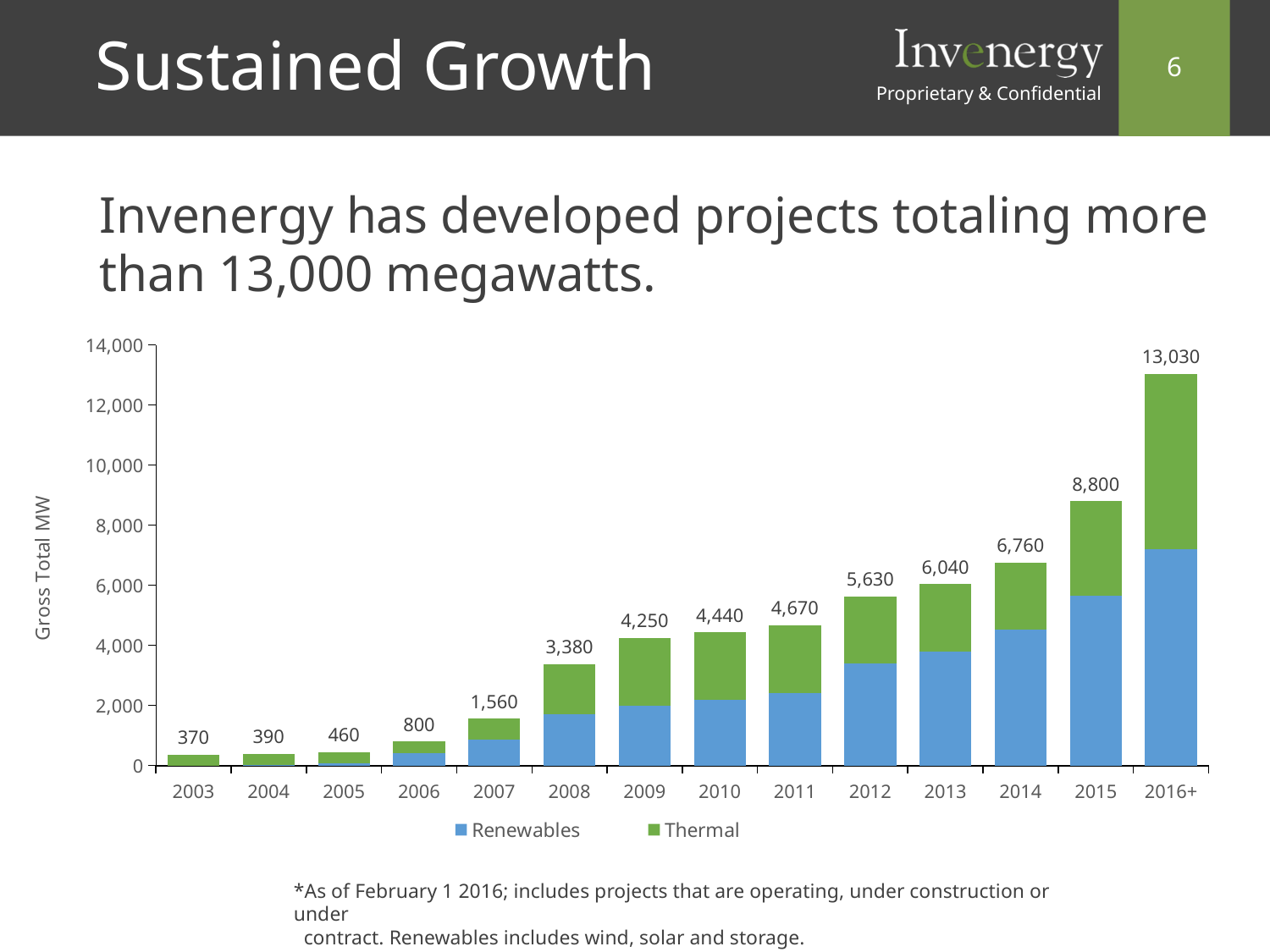
What is the total value labeled on the bar for 2008? 3,380 Is the Renewables value for 2012 greater or less than 2,000? greater Which is larger, the total for 2010 or the total for 2011? 2011 How many years (categories) are shown on the x axis? 14 Do the total values rise or fall from 2003 to 2016+? Rise How many series does the legend list? 2 What kind of chart is shown on the slide? Stacked bar chart What is the total gross MW shown for 2016+? 13,030 Is the Renewables value for 2016+ greater or less than 6,000? greater What is the difference between the total for 2015 and the total for 2014? 2,040 Which year has the lowest total gross MW? 2003 Which category has the highest total gross MW? 2016+